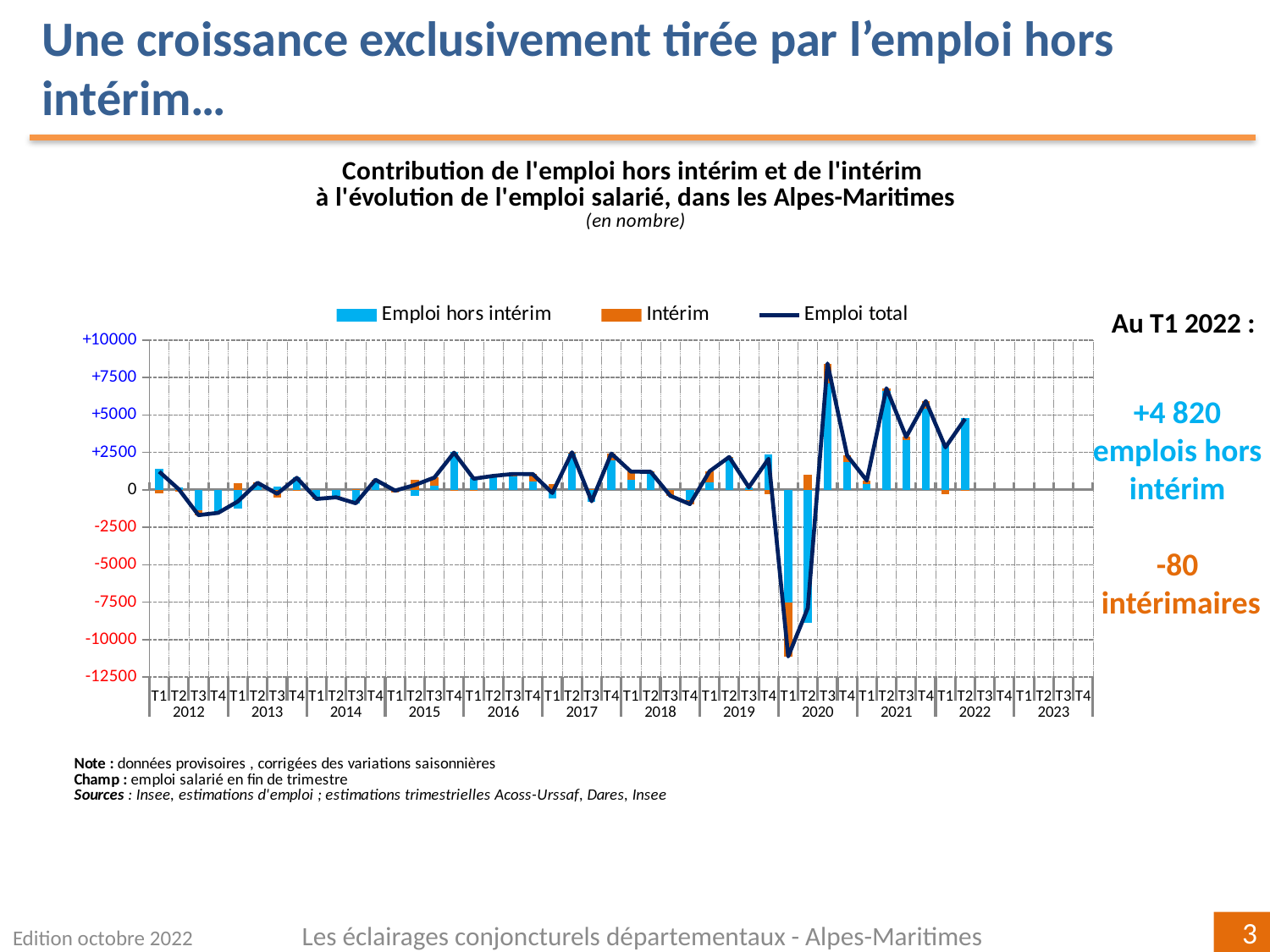
Which colour represents the Intérim series in the chart? Orange How many years are labelled along the x axis of the chart? 12 Is the value of Emploi total at T1 2020 greater or less than -10000? less How many series does the chart legend list? 3 Is the value of Emploi hors intérim at T2 2020 greater or less than -5000? less In which quarter does the Emploi total line reach its lowest point? T1 2020 According to the annotation, what is the value for Intérim at T1 2022? -80 Is the value of Emploi total at T3 2020 greater or less than +7500? greater What kind of chart is shown on the slide? Bar chart combined with a line In which quarter does the Emploi total line reach its highest point? T3 2020 According to the annotation, what is the value for Emploi hors intérim at T1 2022? +4 820 Which is larger, the Emploi total value at T3 2020 or at T2 2021? T3 2020